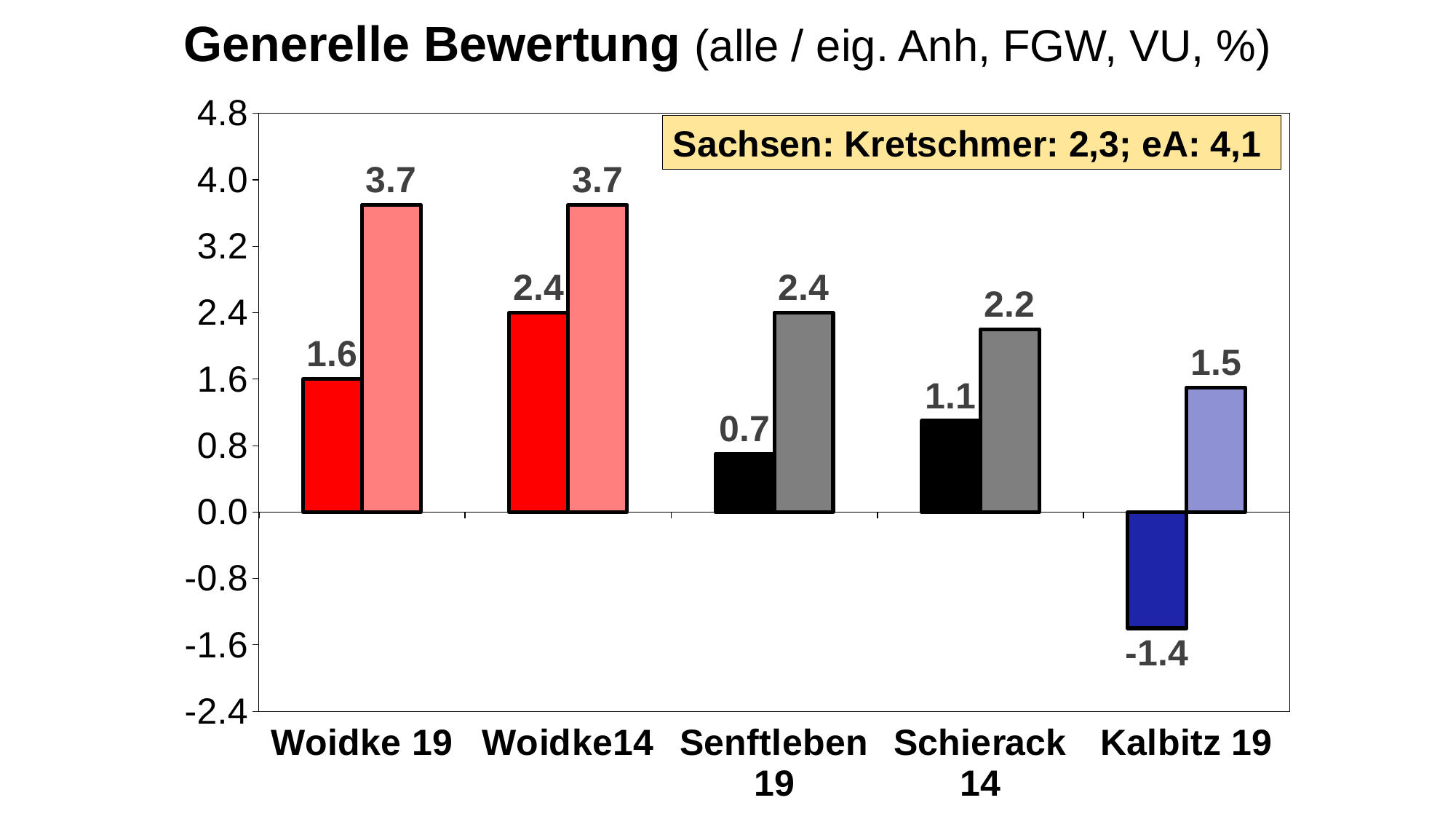
What value does the text box give for Kretschmer in Sachsen? 2,3 What is the value of the right bar (eig. Anh) for Schierack 14? 2.2 What is the value of the left bar (alle) for Kalbitz 19? -1.4 What is the difference between the right bar (eig. Anh) and the left bar (alle) for Woidke 19? 2.1 Which is larger: the left bar (alle) for Woidke14 or the left bar (alle) for Schierack 14? Woidke14 Which category has the highest value among the left bars (alle)? Woidke14 What is the value of the left bar (alle) for Woidke 19? 1.6 What kind of chart is shown on the slide? Bar chart Which category has the lowest value among the left bars (alle)? Kalbitz 19 What is the value of the right bar (eig. Anh) for Senftleben 19? 2.4 How many categories are shown on the x axis? 5 How many bars are shown for each category? 2